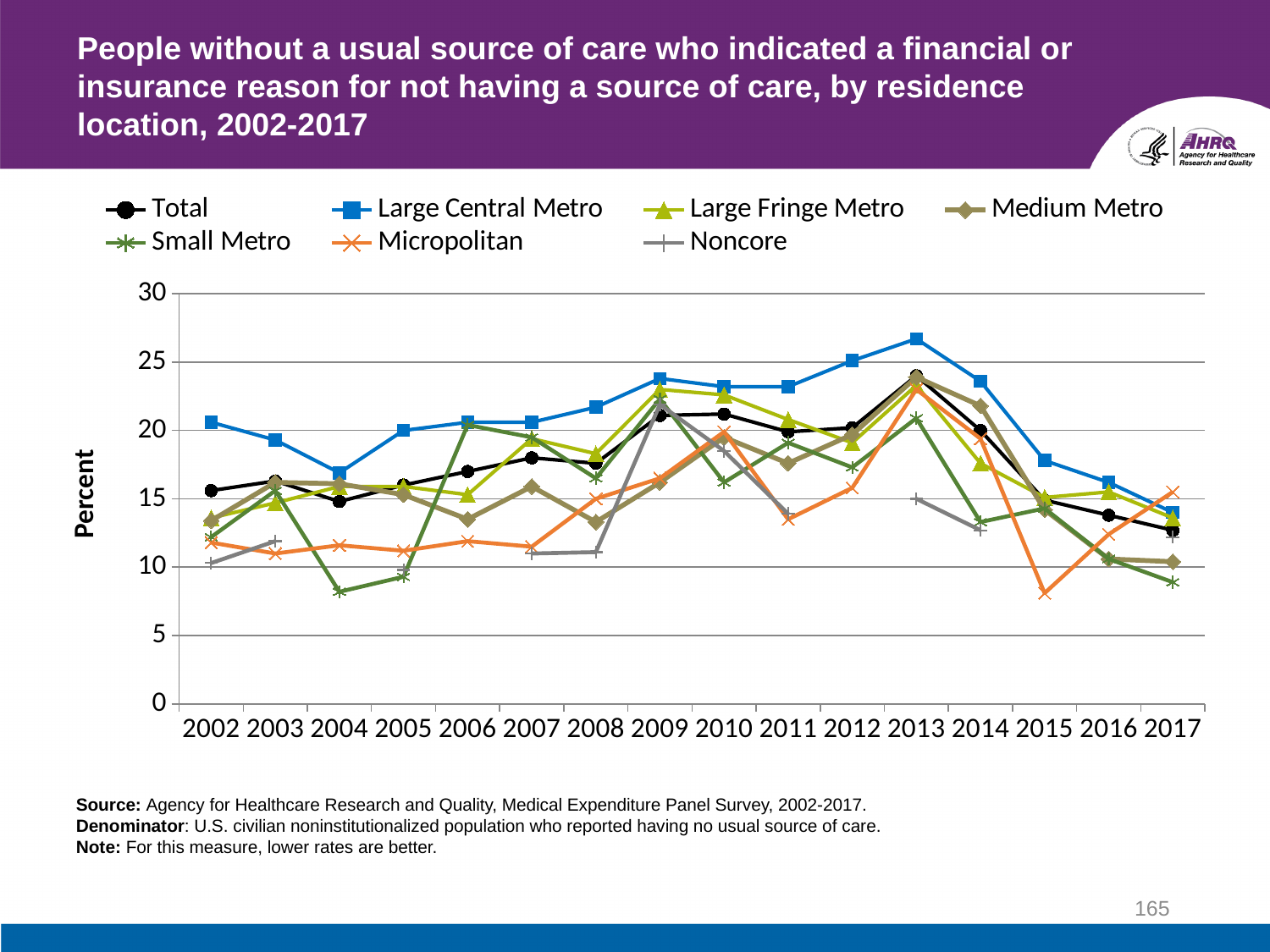
What is the label on the y axis? Percent Is the value for Large Central Metro in 2013 greater or less than 25? greater Is the value for Small Metro in 2004 greater or less than 10? less How many years are shown along the x axis? 16 Is the value for Total in 2017 greater or less than 15? less What kind of chart is shown on the slide? Line chart In which year does the Large Central Metro series reach its highest value? 2013 In 2005, which is larger: the value for Large Central Metro or the value for Micropolitan? Large Central Metro Does the Large Central Metro series rise or fall from 2013 to 2017? Fall Which series has the highest value in 2013? Large Central Metro Which series has the lowest value in 2015? Micropolitan How many series does the legend list? 7